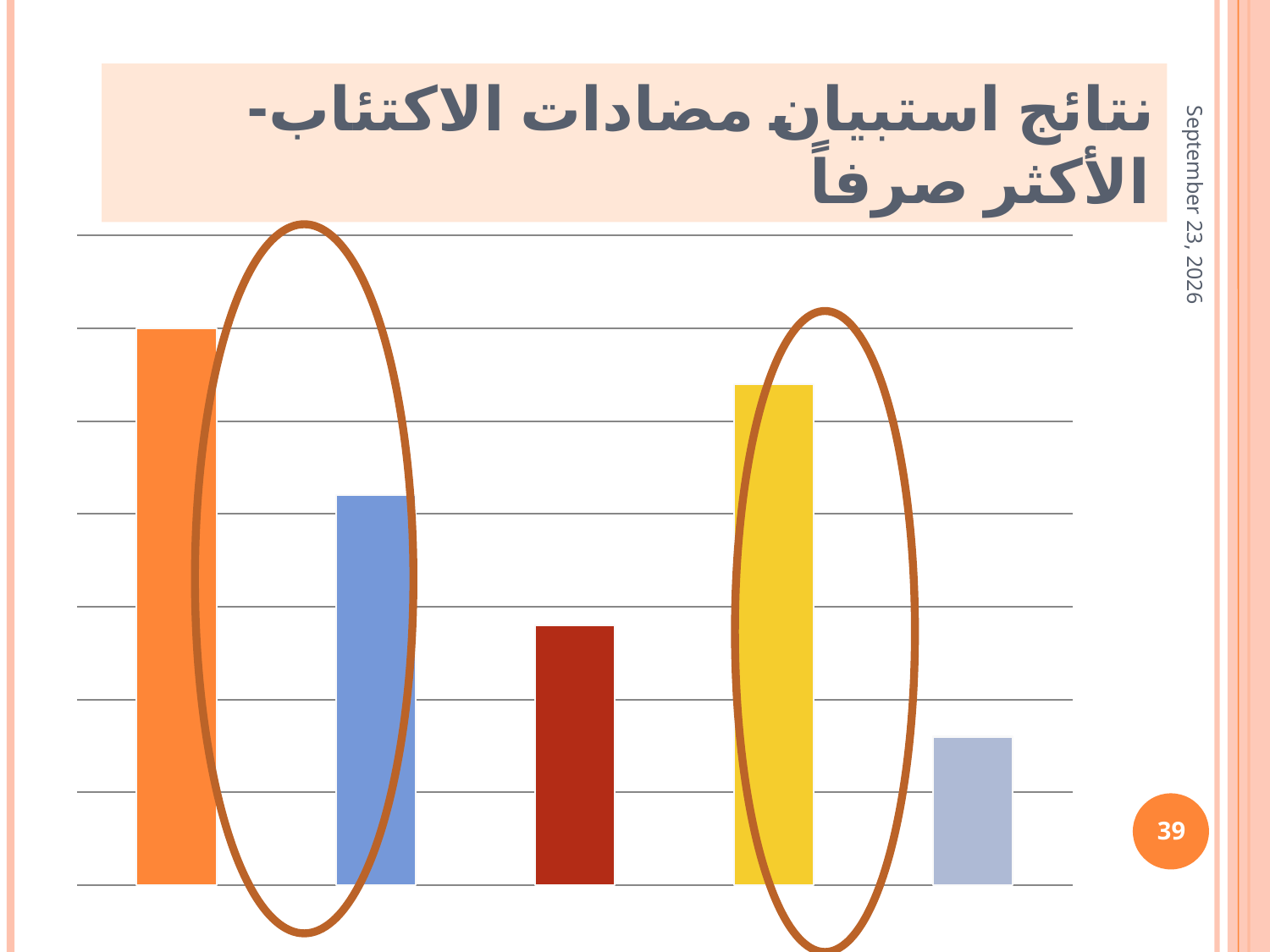
How many bars does the chart contain? 5 Which is taller, the dark red bar or the light blue bar (rightmost)? The dark red bar Which bar is the second tallest in the chart? The yellow bar What is the title of the slide containing the chart? نتائج استبيان مضادات الاكتئاب- الأكثر صرفاً Which bar is the shortest in the chart? The light blue bar (rightmost) Which is taller, the blue bar (second from left) or the dark red bar (middle)? The blue bar Which is taller, the orange bar or the yellow bar? The orange bar Which two bars are circled on the chart? The orange bar and the yellow bar What kind of chart is shown on the slide? Bar chart Which bar is the tallest in the chart? The orange bar (leftmost)